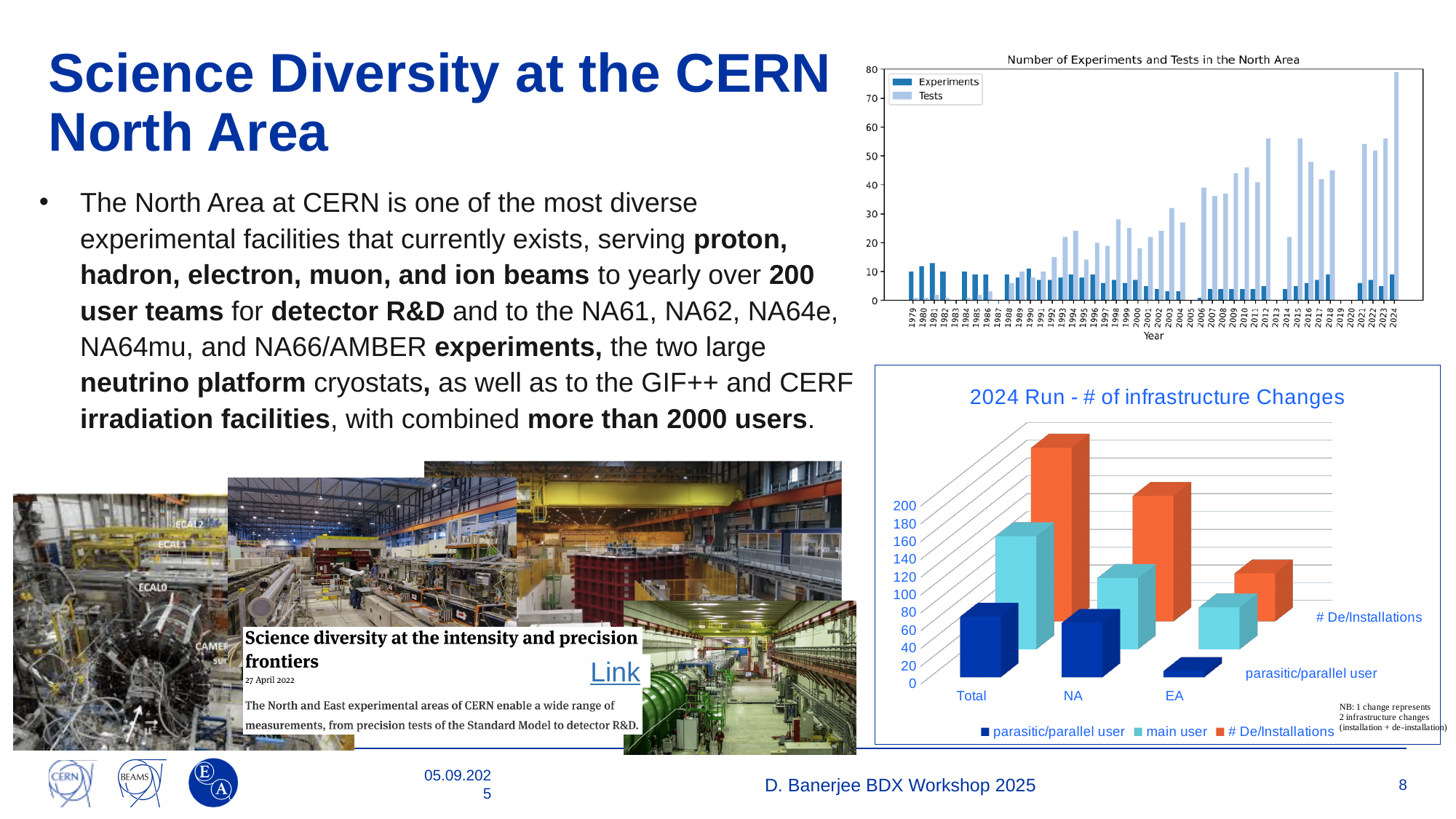
What kind of chart is the 'Number of Experiments and Tests in the North Area' chart? bar chart How many series does the legend of the 'Number of Experiments and Tests in the North Area' chart list? 2 In the 'Number of Experiments and Tests in the North Area' chart, do the Tests values generally rise or fall from 1979 to 2024? rise In the 'Number of Experiments and Tests in the North Area' chart, which is larger in 2024, Experiments or Tests? Tests In the 'Number of Experiments and Tests in the North Area' chart, is the number of Tests in 2024 greater or less than 70? greater What kind of chart is the '2024 Run - # of infrastructure Changes' chart? bar chart In the 'Number of Experiments and Tests in the North Area' chart, is the number of Tests in 2013 greater or less than 50? greater In the '2024 Run - # of infrastructure Changes' chart, is the main user value for Total greater or less than 100? greater In the 'Number of Experiments and Tests in the North Area' chart, which year has the highest number of Tests? 2024 How many categories are shown on the x axis of the '2024 Run - # of infrastructure Changes' chart? 3 In the '2024 Run - # of infrastructure Changes' chart, which category has the highest value for # De/Installations? Total How many series does the legend of the '2024 Run - # of infrastructure Changes' chart list? 3